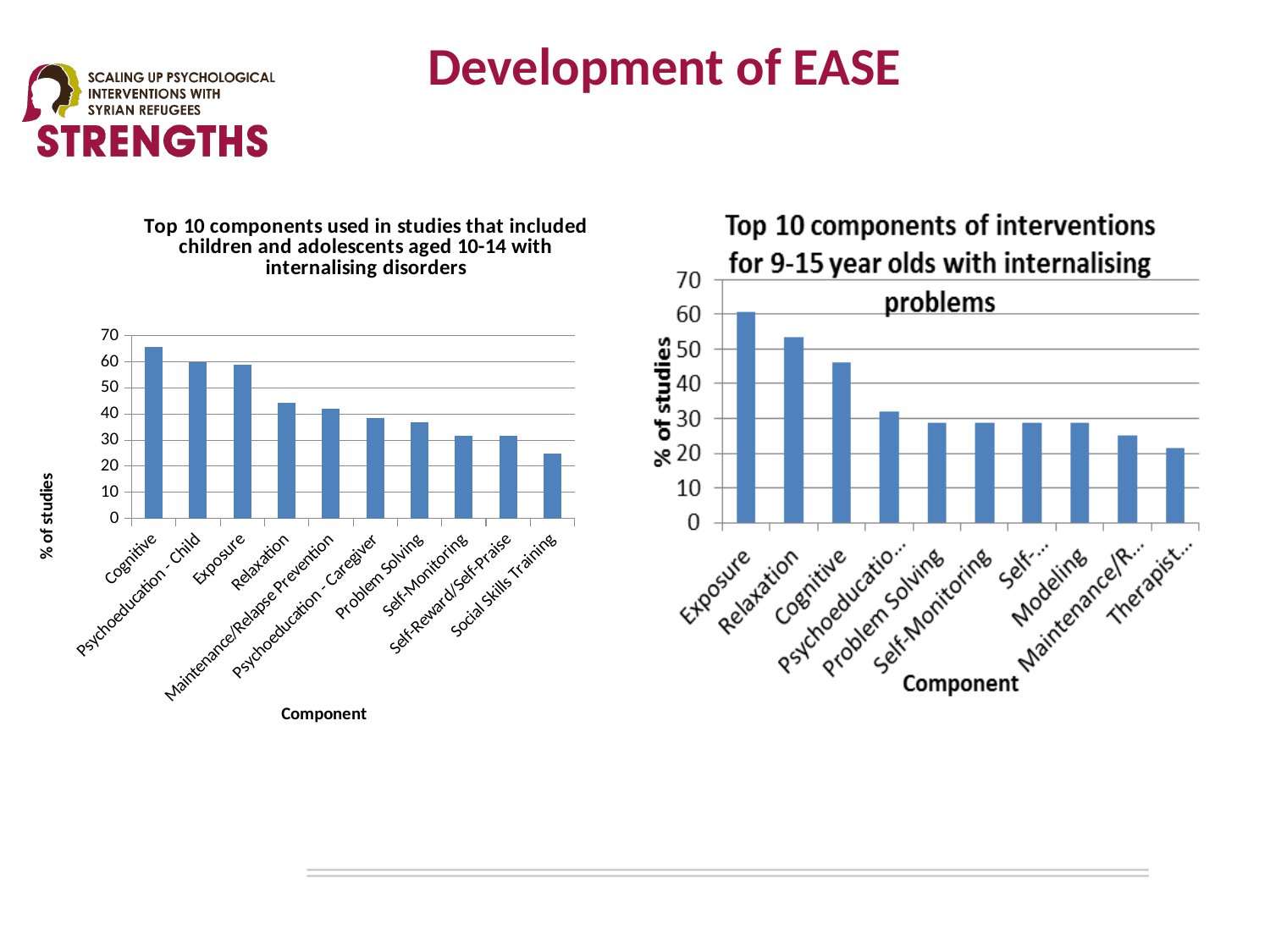
In the left chart (aged 10-14 with internalising disorders), do the values rise or fall from left to right along the x axis? Fall In the left chart (aged 10-14 with internalising disorders), which component has the lowest percentage of studies? Social Skills Training In the left chart (aged 10-14 with internalising disorders), is the value for Social Skills Training greater or less than 30? less In the right chart (9-15 year olds with internalising problems), which is larger: Relaxation or Modeling? Relaxation In the left chart (aged 10-14 with internalising disorders), which is larger: Exposure or Problem Solving? Exposure In the right chart (9-15 year olds with internalising problems), which component has the highest percentage of studies? Exposure In the right chart (9-15 year olds with internalising problems), is the value for Cognitive greater or less than 40? greater In the right chart (9-15 year olds with internalising problems), what is the label on the y axis? % of studies In the left chart (aged 10-14 with internalising disorders), which component has the highest percentage of studies? Cognitive In the left chart (aged 10-14 with internalising disorders), what kind of chart is shown? Bar chart In the left chart (aged 10-14 with internalising disorders), is the value for Relaxation greater or less than 40? greater In the left chart (aged 10-14 with internalising disorders), how many components are plotted? 10